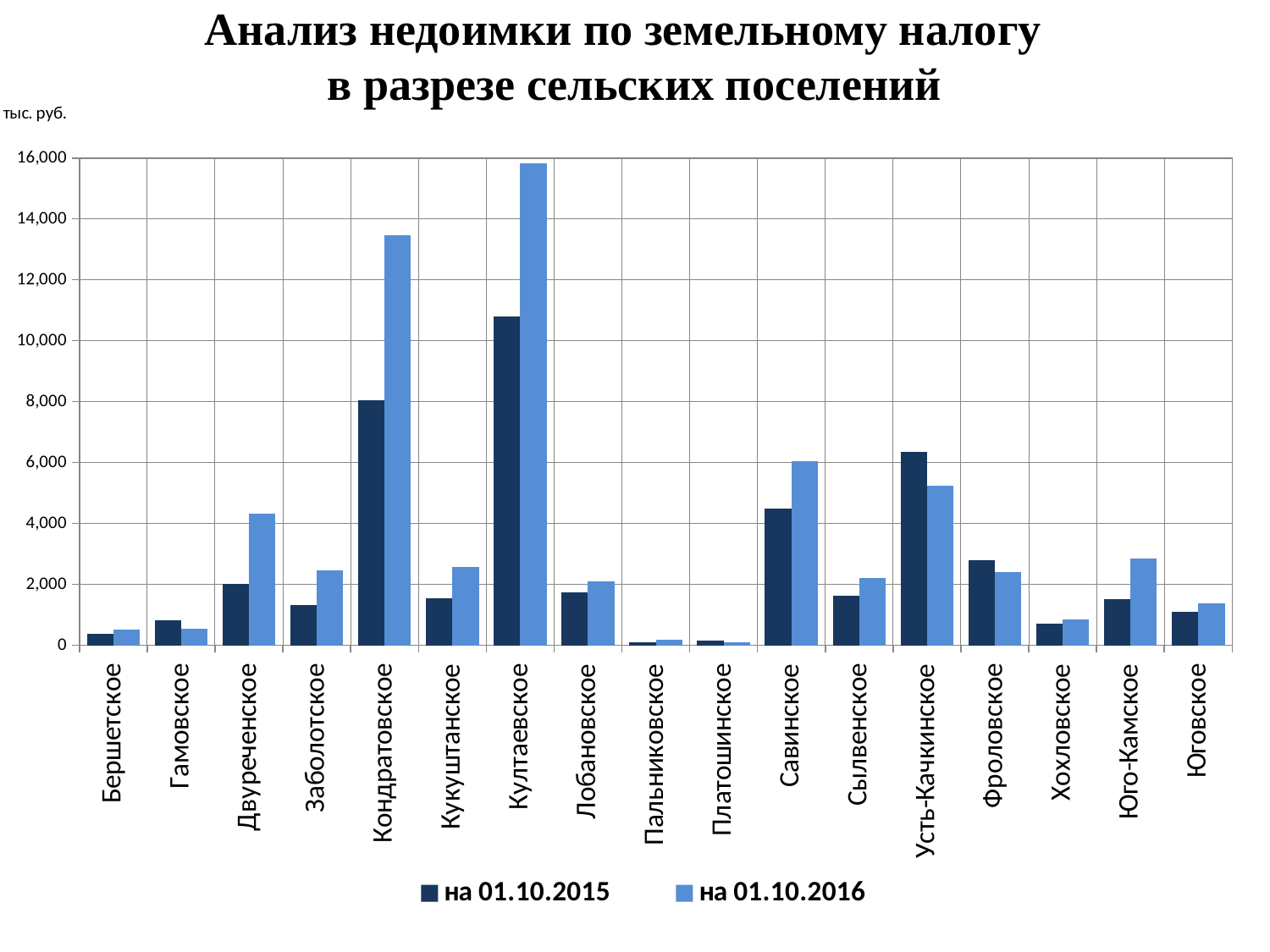
Which settlement has the highest value for на 01.10.2016? Култаевское Is the value for Култаевское for на 01.10.2015 greater or less than 10,000? greater For Кондратовское, which series has the larger value: на 01.10.2015 or на 01.10.2016? на 01.10.2016 What kind of chart is shown on the slide? bar chart Which settlement has the highest value for на 01.10.2015? Култаевское Is the value for Хохловское for на 01.10.2015 greater or less than 2,000? less How many series does the legend list? 2 What unit is indicated above the vertical axis of the chart? тыс. руб. Is the value for Усть-Качкинское for на 01.10.2015 greater or less than 6,000? greater How many settlements (categories) are shown on the x axis? 17 For Усть-Качкинское, which series has the larger value: на 01.10.2015 or на 01.10.2016? на 01.10.2015